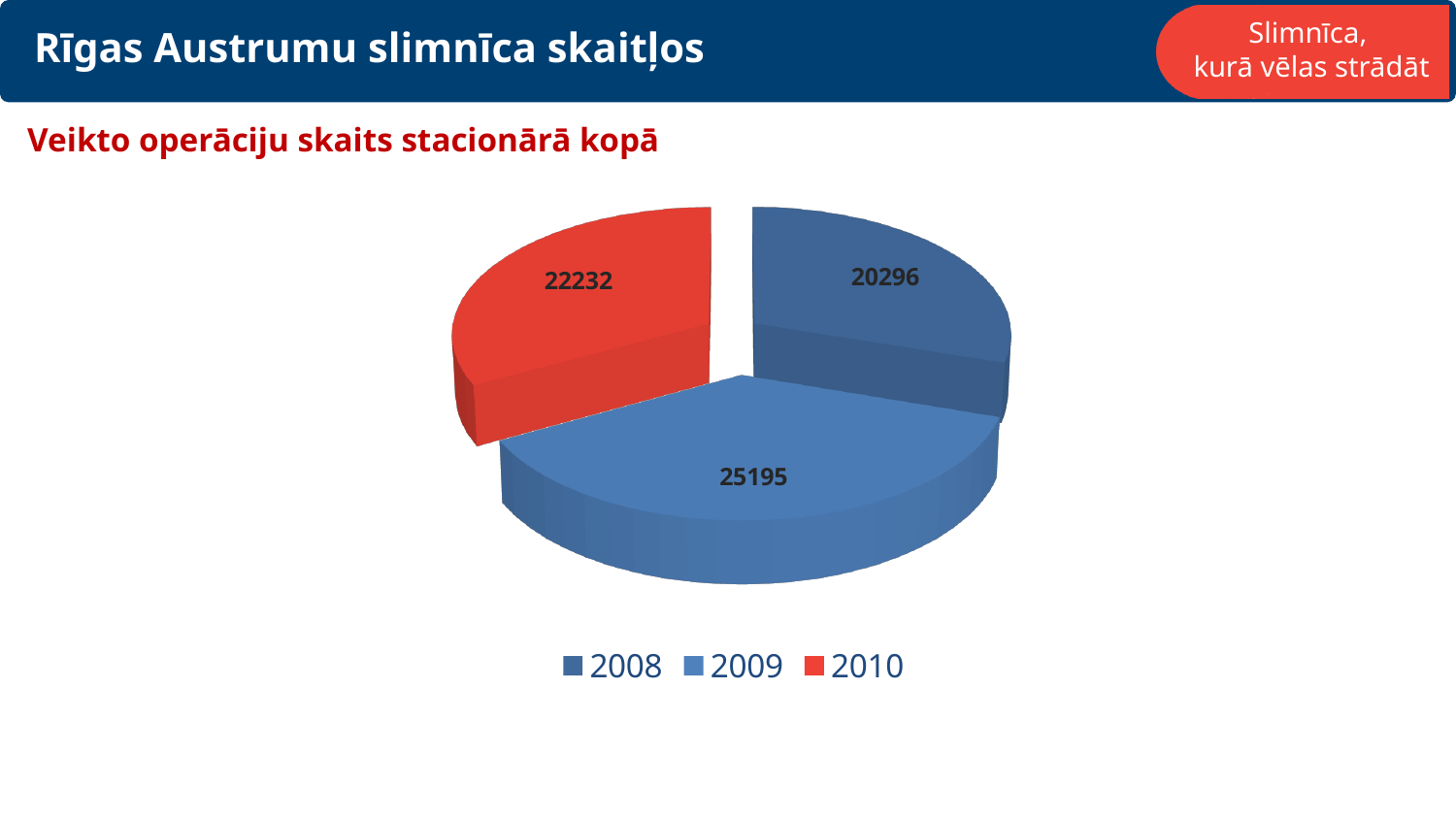
How many slices does the pie chart have? 3 What is the difference between the values for 2010 and 2008? 1936 What is the value for 2010 in the pie chart? 22232 What is the value for 2009 in the pie chart? 25195 What is the title of the chart? Veikto operāciju skaits stacionārā kopā How many entries does the legend list? 3 What is the value for 2008 in the pie chart? 20296 Which is larger, the value for 2010 or the value for 2008? 2010 Which year has the lowest value in the pie chart? 2008 What is the difference between the values for 2009 and 2008? 4899 Which year has the highest value in the pie chart? 2009 What type of chart is shown on the slide? pie chart